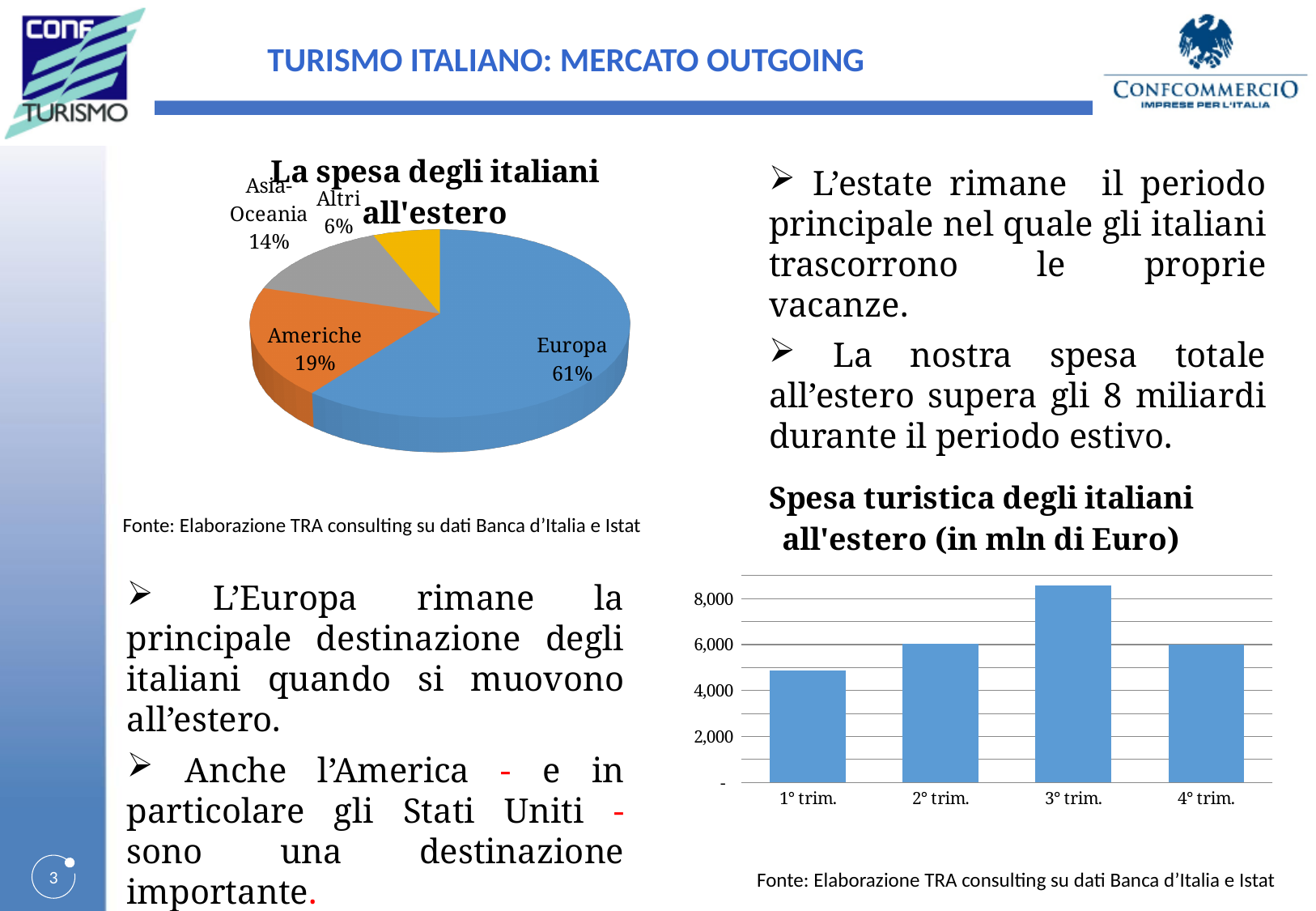
In the pie chart 'La spesa degli italiani all'estero', what is the difference between the Europa share and the Americhe share? 42% In the bar chart 'Spesa turistica degli italiani all'estero', is the value for 3° trim. greater or less than 8,000? greater What kind of chart is 'Spesa turistica degli italiani all'estero (in mln di Euro)'? bar chart In the bar chart 'Spesa turistica degli italiani all'estero', which quarter has the highest value? 3° trim. In the pie chart 'La spesa degli italiani all'estero', what share does Europa have? 61% In the pie chart 'La spesa degli italiani all'estero', what share does Americhe have? 19% In the pie chart 'La spesa degli italiani all'estero', what share does Asia-Oceania have? 14% In the bar chart 'Spesa turistica degli italiani all'estero', which quarter has the lowest value? 1° trim. In the pie chart 'La spesa degli italiani all'estero', which slice is the largest? Europa In the bar chart 'Spesa turistica degli italiani all'estero', is the value for 1° trim. greater or less than 6,000? less How many slices does the pie chart 'La spesa degli italiani all'estero' have? 4 In the pie chart 'La spesa degli italiani all'estero', which slice is the smallest? Altri